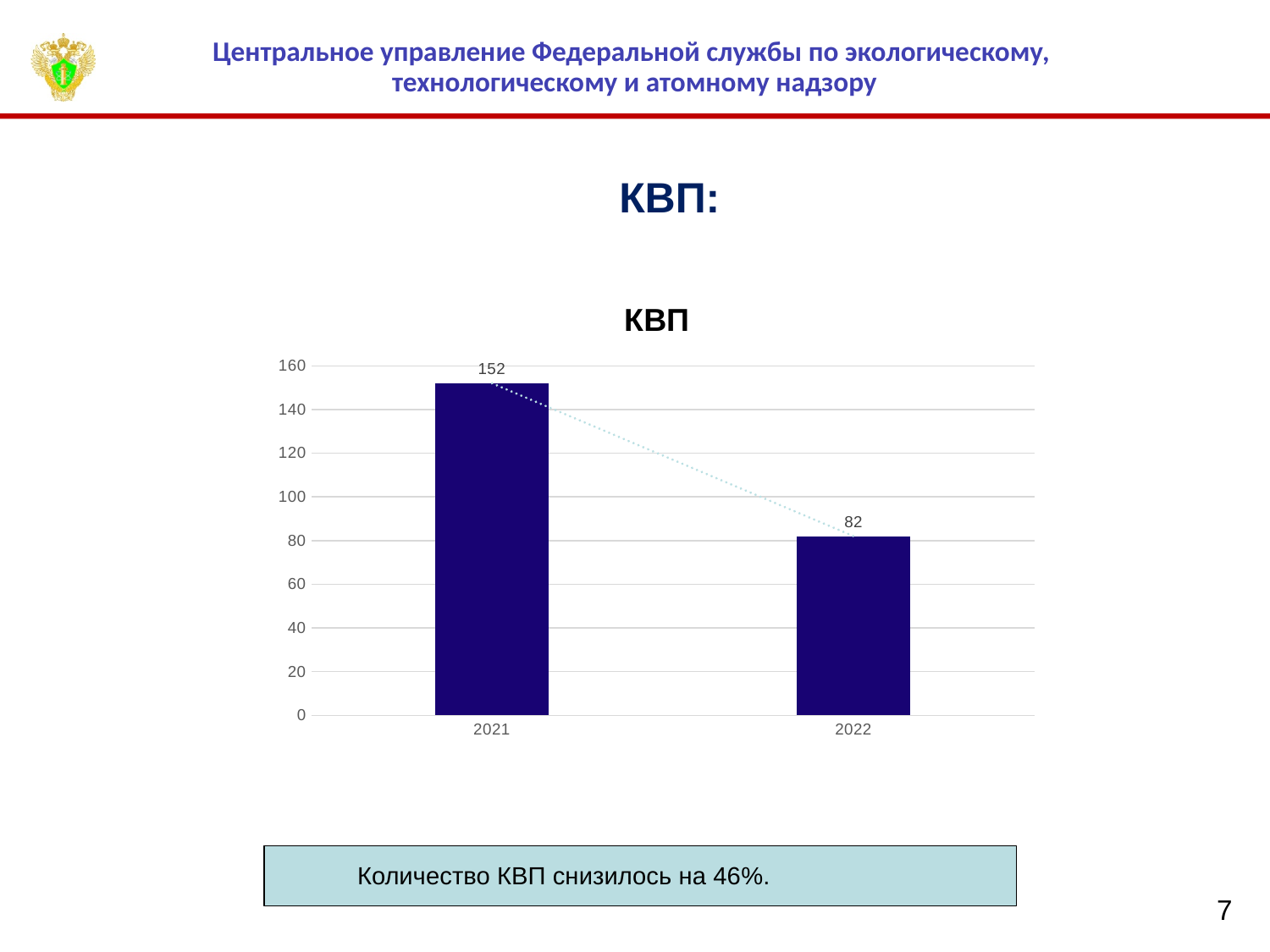
What is the title of the chart on the slide? КВП What is the value for 2021 in the КВП chart? 152 What is the value for 2022 in the КВП chart? 82 Do the values in the КВП chart rise or fall from 2021 to 2022? fall How many years are shown on the x axis of the КВП chart? 2 What is the difference between the 2021 and 2022 values in the КВП chart? 70 Which year has the highest value in the КВП chart? 2021 Is the value for 2022 in the КВП chart greater or less than 100? less What kind of chart is the КВП chart? bar chart Which year has the lowest value in the КВП chart? 2022 Is the value for 2021 in the КВП chart greater or less than 140? greater Which is larger in the КВП chart, the value for 2021 or the value for 2022? 2021